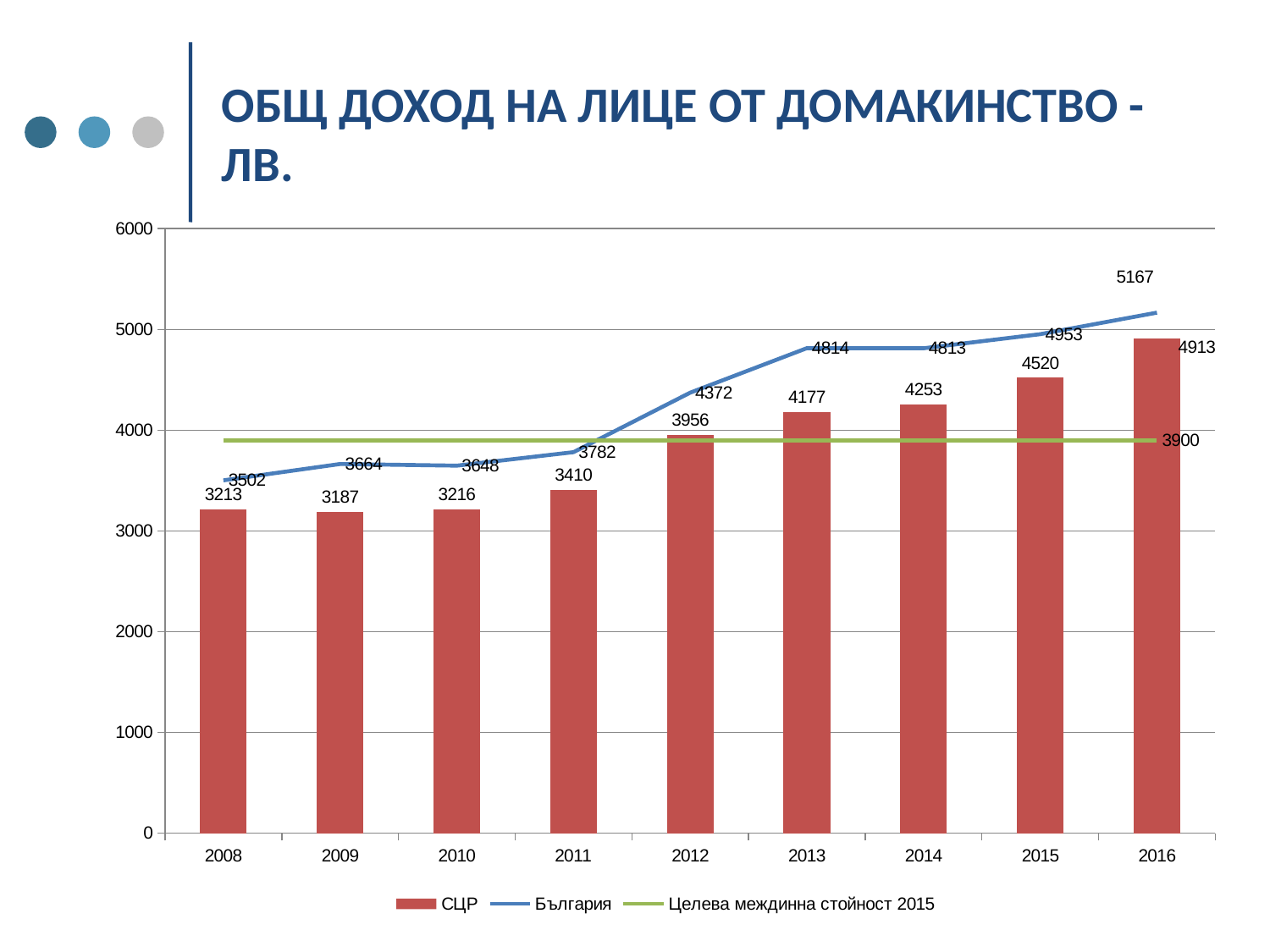
In which year is the СЦР bar the lowest? 2009 Do the СЦР values generally rise or fall from 2009 to 2016? rise In which year is the СЦР bar the highest? 2016 What is the difference between the СЦР values for 2015 and 2014? 267 What is the value of the СЦР bar for 2016? 4913 How many series does the legend list? 3 What is the value of the България line for 2013? 4814 What is the value of the Целева междинна стойност 2015 line? 3900 Which is larger in 2012, the СЦР bar or the България line? България Is the СЦР value for 2011 greater or less than 3900? less How many years are shown on the x axis? 9 What is the difference between the България value and the СЦР value in 2016? 254